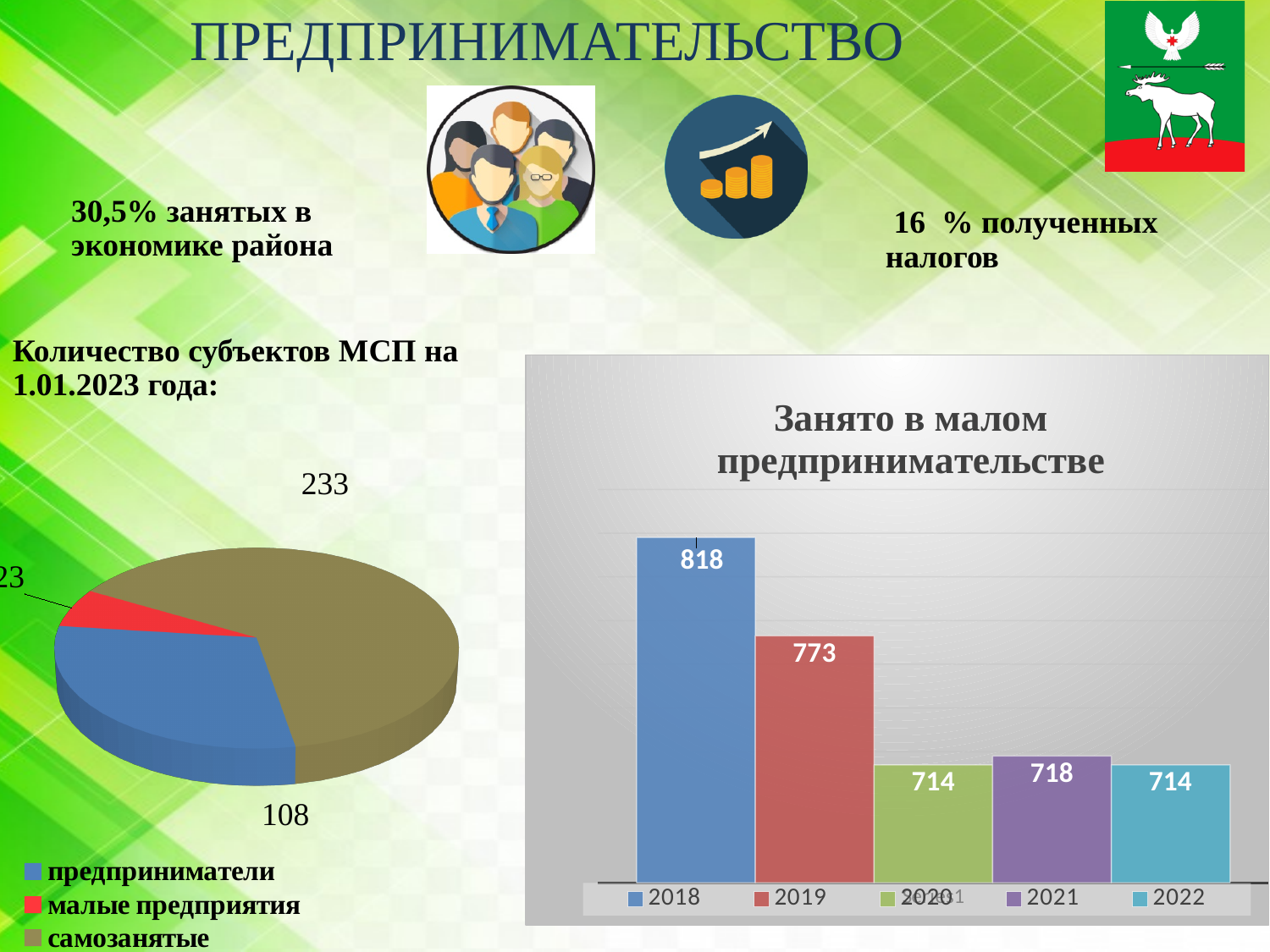
How many bars are shown in the bar chart 'Занято в малом предпринимательстве'? 5 In the bar chart 'Занято в малом предпринимательстве', which year has the highest value? 2018 In the pie chart on the left, what is the value for самозанятые? 233 In the bar chart 'Занято в малом предпринимательстве', what is the value for 2018? 818 In the bar chart 'Занято в малом предпринимательстве', what is the value for 2021? 718 In the pie chart on the left, what is the value for предприниматели? 108 In the bar chart 'Занято в малом предпринимательстве', do the values rise or fall from 2018 to 2020? fall In the bar chart 'Занято в малом предпринимательстве', what is the difference between the values for 2018 and 2019? 45 In the bar chart 'Занято в малом предпринимательстве', what is the value for 2019? 773 In the bar chart 'Занято в малом предпринимательстве', which is larger, the value for 2020 or for 2021? 2021 In the pie chart on the left, which category has the largest slice? самозанятые What kind of chart is 'Занято в малом предпринимательстве'? bar chart